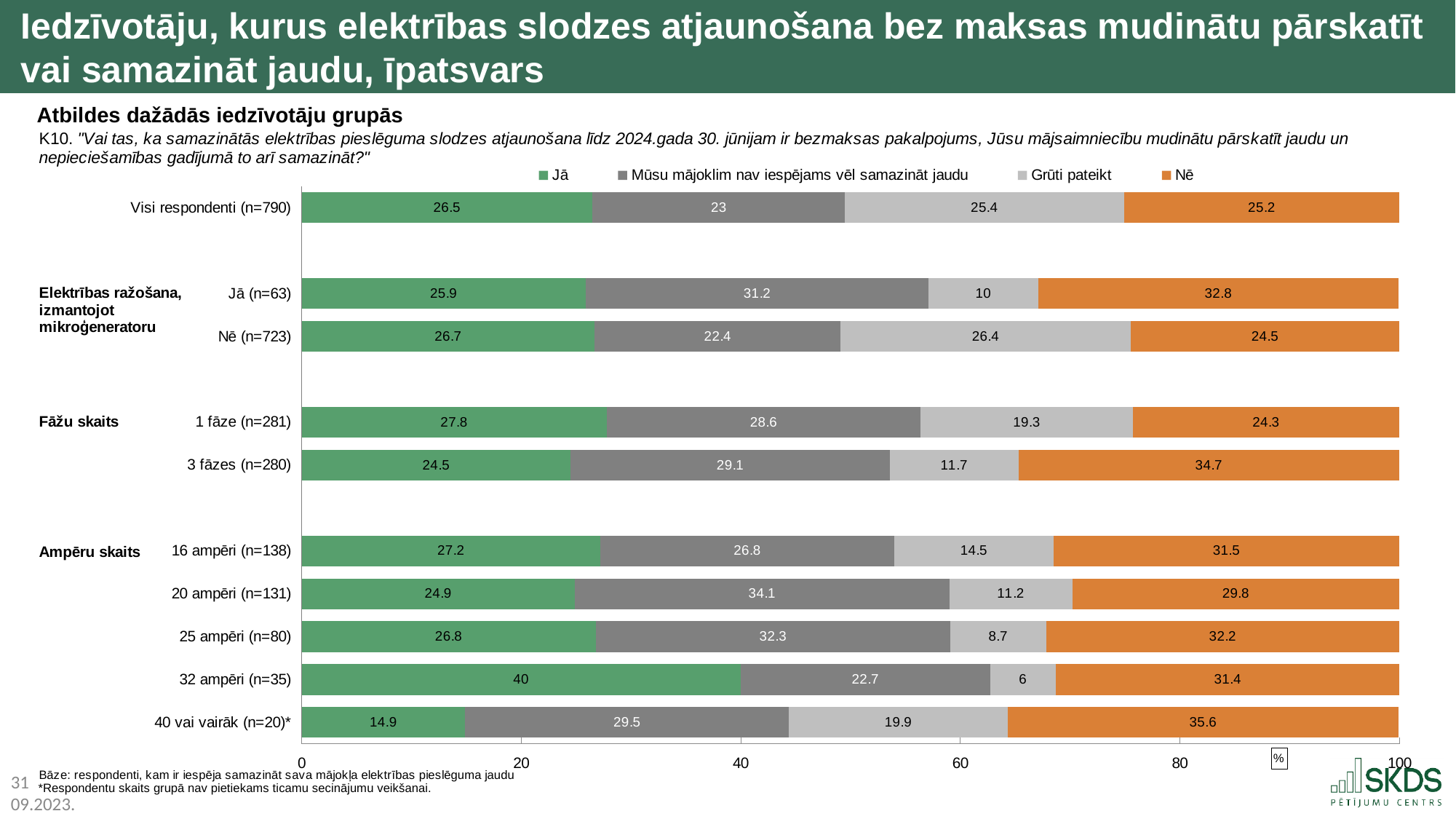
What is the value of "Mūsu mājoklim nav iespējams vēl samazināt jaudu" for "20 ampēri (n=131)"? 34.1 Which group has the lowest value for "Jā"? 40 vai vairāk (n=20)* What type of chart is shown on the slide? Stacked bar chart Which group has the lowest value for "Grūti pateikt"? 32 ampēri (n=35) What is the value of "Nē" for "3 fāzes (n=280)"? 34.7 What is the value of "Grūti pateikt" for "25 ampēri (n=80)"? 8.7 Which group has the highest value for "Jā"? 32 ampēri (n=35) How many respondent groups (bars) are plotted in the chart? 10 Which has a larger "Jā" value: "1 fāze (n=281)" or "3 fāzes (n=280)"? 1 fāze (n=281) What is the difference between the "Nē" value for "Jā (n=63)" and the "Nē" value for "Nē (n=723)"? 8.3 How many series does the legend list? 4 What is the value of "Jā" for "Visi respondenti (n=790)"? 26.5